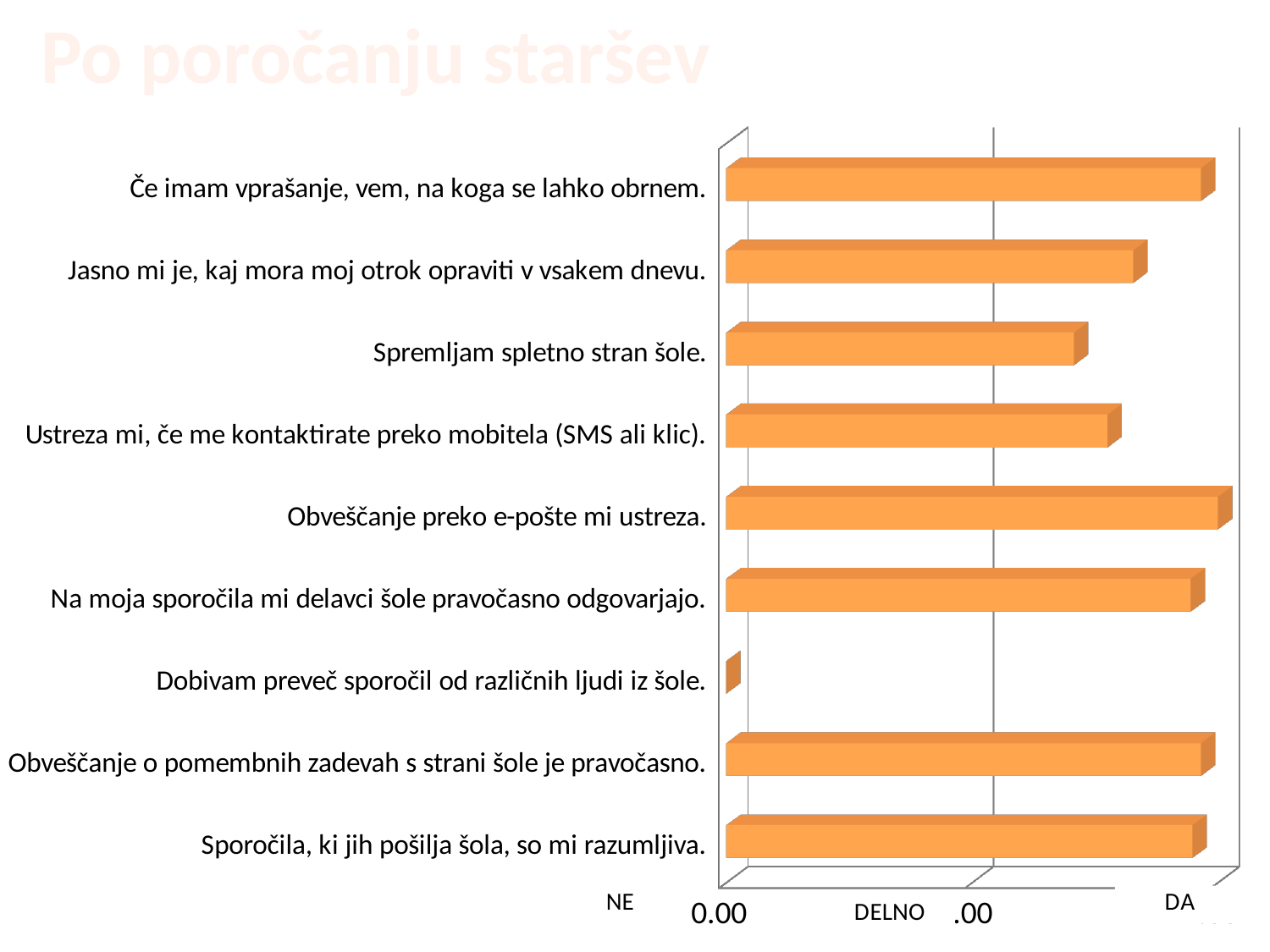
Which statement has the longest bar in the chart? Obveščanje preko e-pošte mi ustreza. Which has the longer bar: 'Obveščanje preko e-pošte mi ustreza.' or 'Spremljam spletno stran šole.'? Obveščanje preko e-pošte mi ustreza. What is the title of the slide above the chart? Po poročanju staršev How many statements (categories) are plotted in the chart? 9 Which has the longer bar: 'Dobivam preveč sporočil od različnih ljudi iz šole.' or 'Sporočila, ki jih pošilja šola, so mi razumljiva.'? Sporočila, ki jih pošilja šola, so mi razumljiva. Which has the longer bar: 'Jasno mi je, kaj mora moj otrok opraviti v vsakem dnevu.' or 'Spremljam spletno stran šole.'? Jasno mi je, kaj mora moj otrok opraviti v vsakem dnevu. What three response labels are shown along the horizontal axis of the chart? NE, DELNO, DA What kind of chart is shown on the slide? bar chart Which statement has the shortest bar in the chart? Dobivam preveč sporočil od različnih ljudi iz šole.